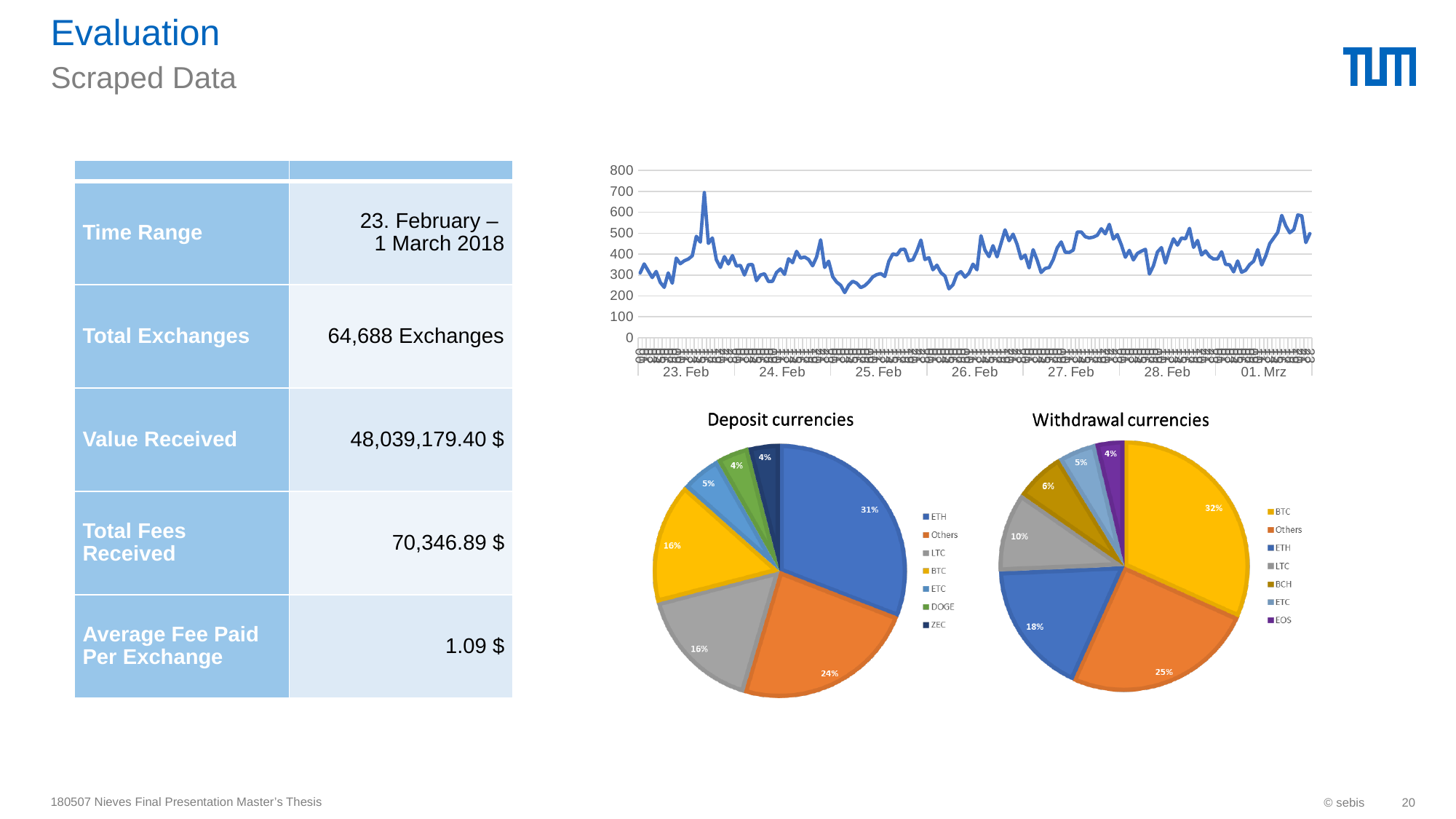
In the Deposit currencies pie chart, what share does ETH have? 31% In the Deposit currencies pie chart, what is the difference between the ETH share and the BTC share? 15% In the Deposit currencies pie chart, what share does Others have? 24% What kind of chart is the chart in the top right of the slide? Line chart In the Withdrawal currencies pie chart, what share does BTC have? 32% In the Withdrawal currencies pie chart, which is larger, the share of ETH or the share of LTC? ETH In the Withdrawal currencies pie chart, which currency has the smallest share? EOS In the Deposit currencies pie chart, which currency has the largest share? ETH In the line chart at the top right, is the highest peak on 23. Feb greater or less than 600? greater In the Deposit currencies pie chart, how many slices are there? 7 In the Withdrawal currencies pie chart, what share does BCH have? 6% How many entries does the legend of the Withdrawal currencies chart list? 7